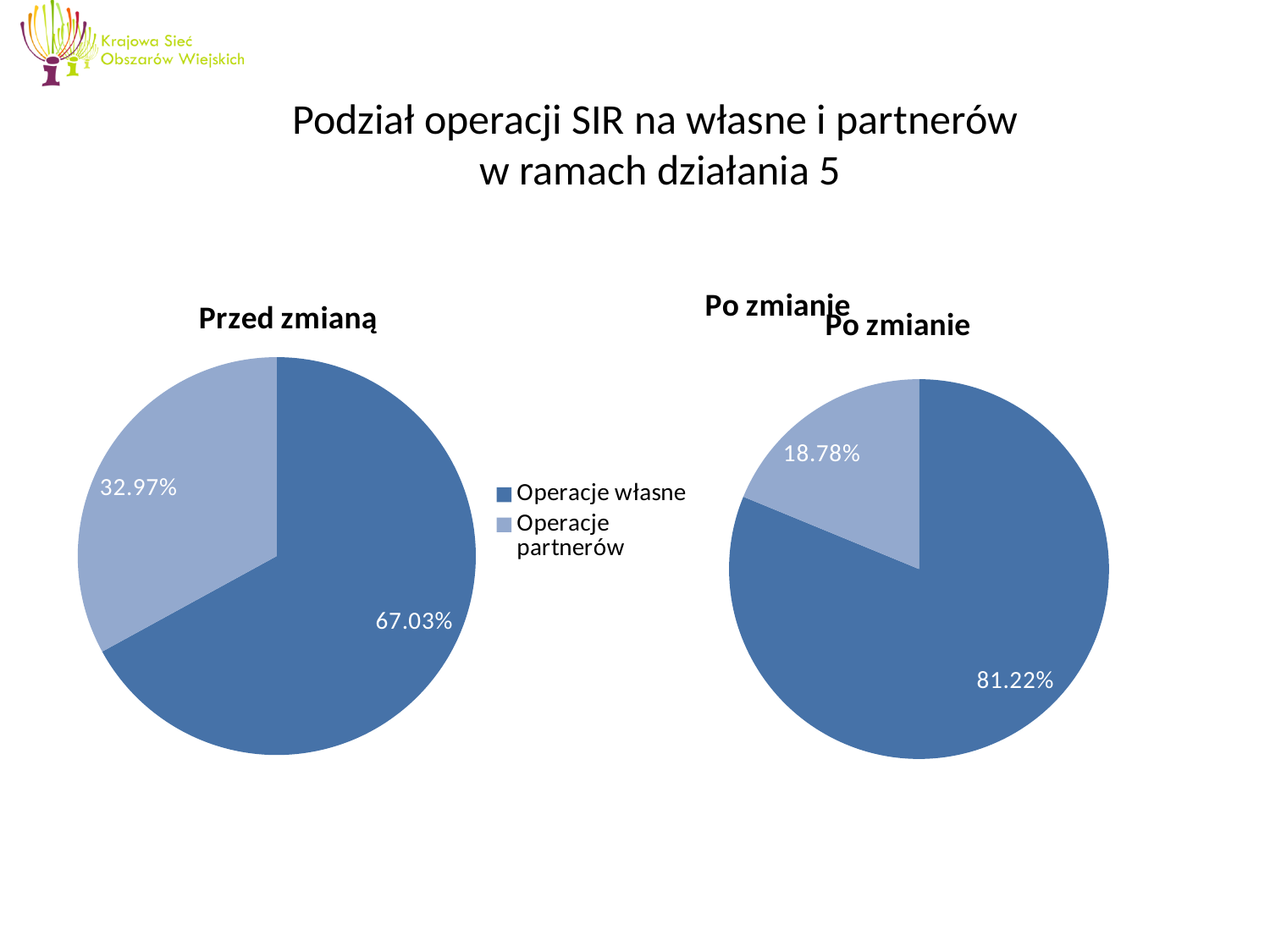
In the 'Przed zmianą' chart, what share is labelled for Operacje własne? 67.03% In the 'Przed zmianą' chart, which category has the largest slice? Operacje własne In the 'Przed zmianą' chart, what share is labelled for Operacje partnerów? 32.97% In the 'Po zmianie' chart, what share is labelled on the smaller (light blue) slice? 18.78% How many entries does the legend next to the 'Przed zmianą' chart list? 2 In the 'Przed zmianą' chart, what is the difference between the Operacje własne share and the Operacje partnerów share? 34.06% How many slices does the 'Po zmianie' pie chart have? 2 What kind of chart is the 'Przed zmianą' chart? Pie chart In the 'Przed zmianą' chart, which category has the smallest slice? Operacje partnerów Which chart shows a larger share for the dark blue slice, 'Przed zmianą' or 'Po zmianie'? Po zmianie In the 'Po zmianie' chart, what share is labelled on the larger (dark blue) slice? 81.22% In the 'Po zmianie' chart, what is the difference between the larger slice and the smaller slice? 62.44%